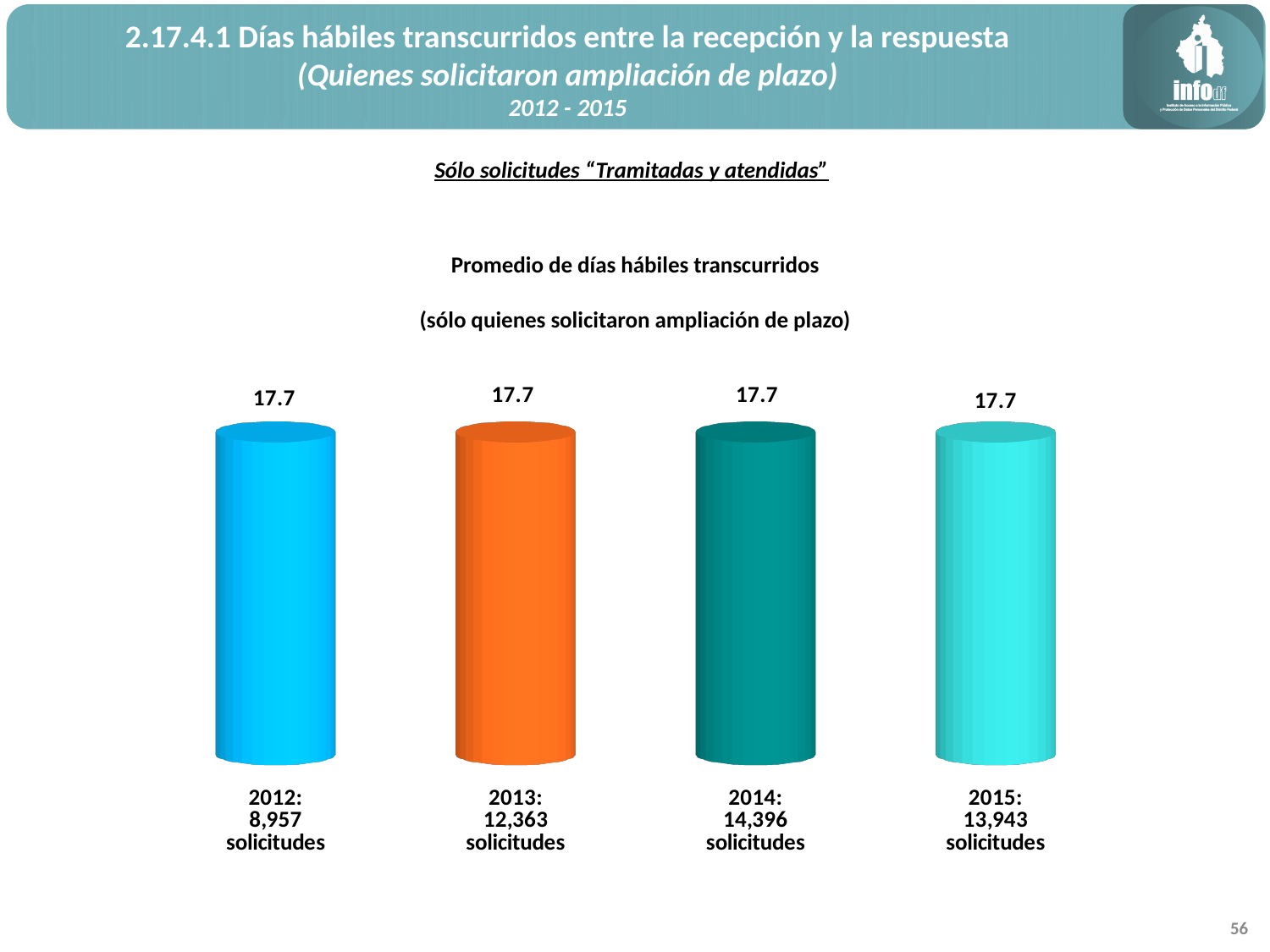
What value is printed above the bar for 2013? 17.7 What colour is the bar for 2013? Orange How many bars (years) does the chart show? 4 What value is printed above the bar for 2014? 17.7 How many solicitudes are listed under the 2015 bar? 13,943 solicitudes What is the difference between the value for 2015 and the value for 2012? 0 How many solicitudes are listed under the 2012 bar? 8,957 solicitudes What value is printed above the bar for 2015? 17.7 What kind of chart is shown on the slide? Bar chart How many solicitudes are listed under the 2014 bar? 14,396 solicitudes Do the plotted values rise, fall, or stay the same from 2012 to 2015? Stay the same What is the average number of business days (promedio de días hábiles transcurridos) shown for 2012? 17.7